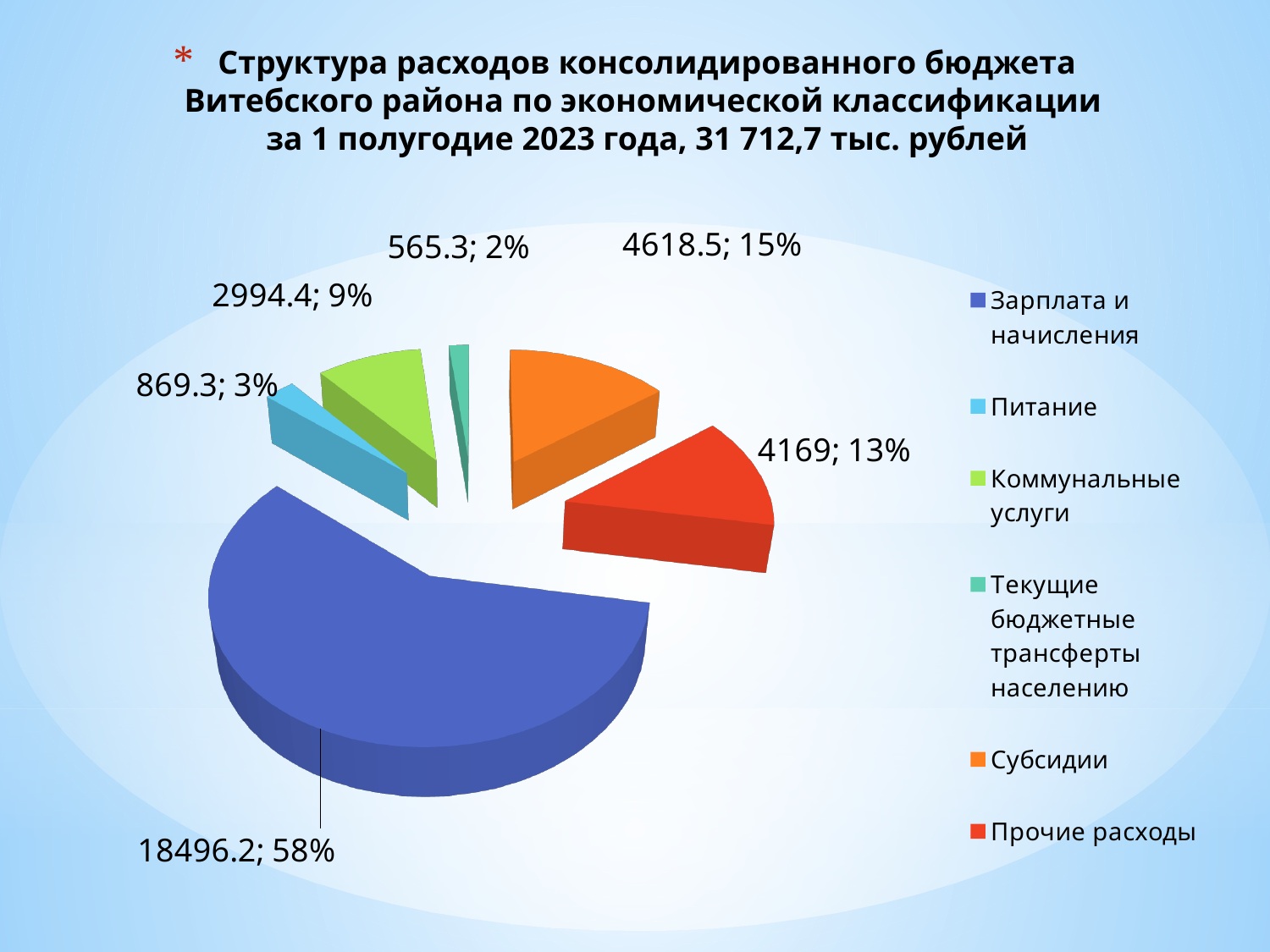
What value is shown for Субсидии? 4618.5 Which is larger, Субсидии or Прочие расходы? Субсидии What value is shown for Зарплата и начисления? 18496.2 How many categories does the legend of the pie chart list? 6 What kind of chart is shown on the slide? pie chart What share of the pie does Зарплата и начисления take? 58% Which category has the smallest slice of the pie? Текущие бюджетные трансферты населению What share of the pie does Прочие расходы take? 13% What is the difference between the values for Субсидии and Прочие расходы? 449.5 What value is shown for Коммунальные услуги? 2994.4 Which category has the largest slice of the pie? Зарплата и начисления What colour is the slice for Питание? light blue